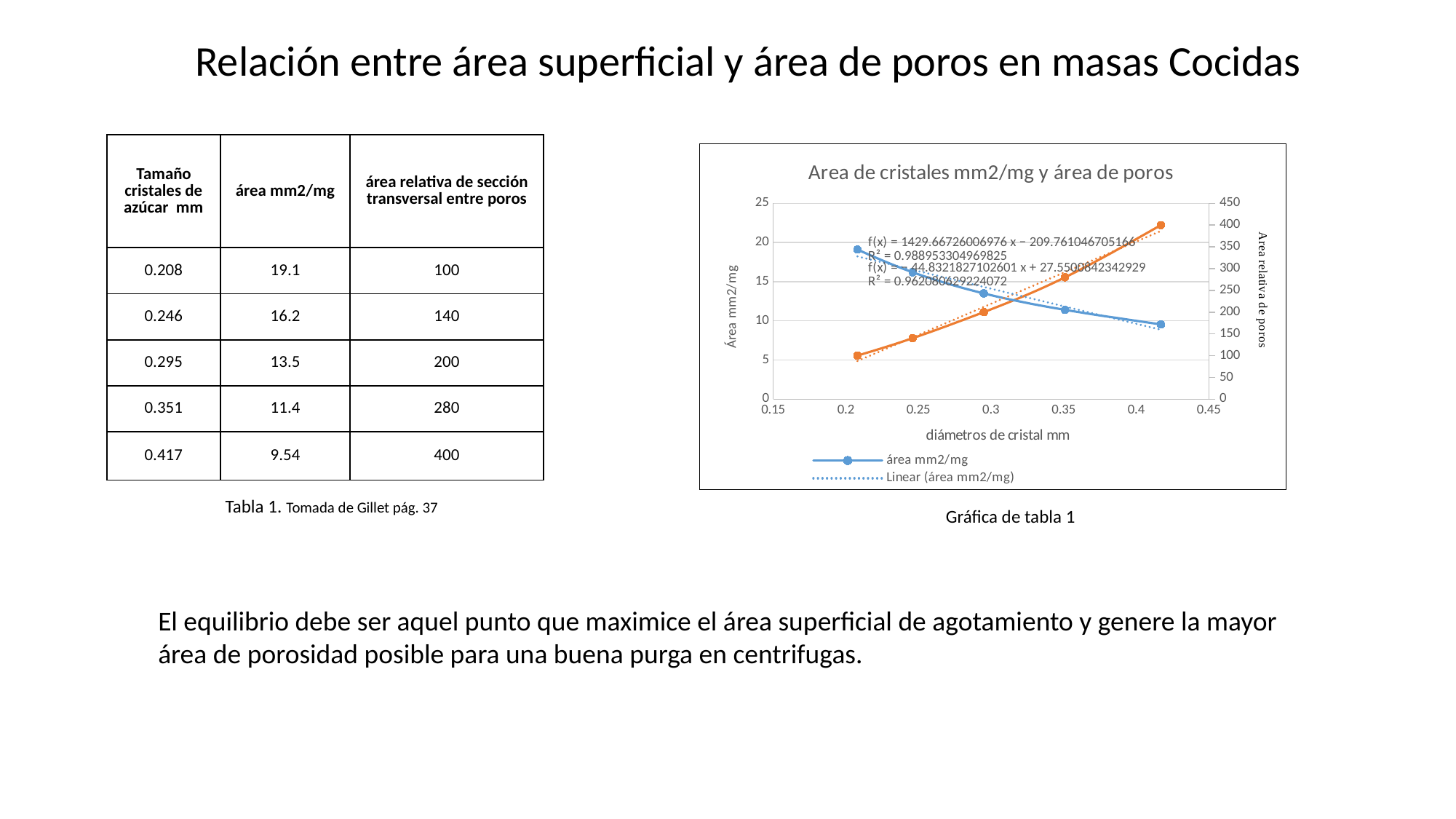
How many data points does the blue 'área mm2/mg' series have in the chart? 5 In the chart, is the 'área mm2/mg' value at a crystal diameter of 0.417 mm greater or less than 10? less In the chart, is the orange series value (right axis) at a crystal diameter of 0.417 mm greater or less than 350? greater What kind of chart is shown on the slide? line chart In the chart, which is larger: the 'área mm2/mg' value at a diameter of 0.246 mm or at 0.351 mm? 0.246 mm At which crystal diameter does the blue 'área mm2/mg' series reach its lowest value in the chart? 0.417 What is the label of the x axis of the chart? diámetros de cristal mm In the chart, is the 'área mm2/mg' value at a crystal diameter of 0.208 mm greater or less than 15? greater Does the blue 'área mm2/mg' series rise or fall as the crystal diameter increases along the x axis? fall At which crystal diameter does the blue 'área mm2/mg' series reach its highest value in the chart? 0.208 What is the title of the chart? Area de cristales mm2/mg y área de poros Does the orange series (área relativa de poros) rise or fall as the crystal diameter increases along the x axis? rise